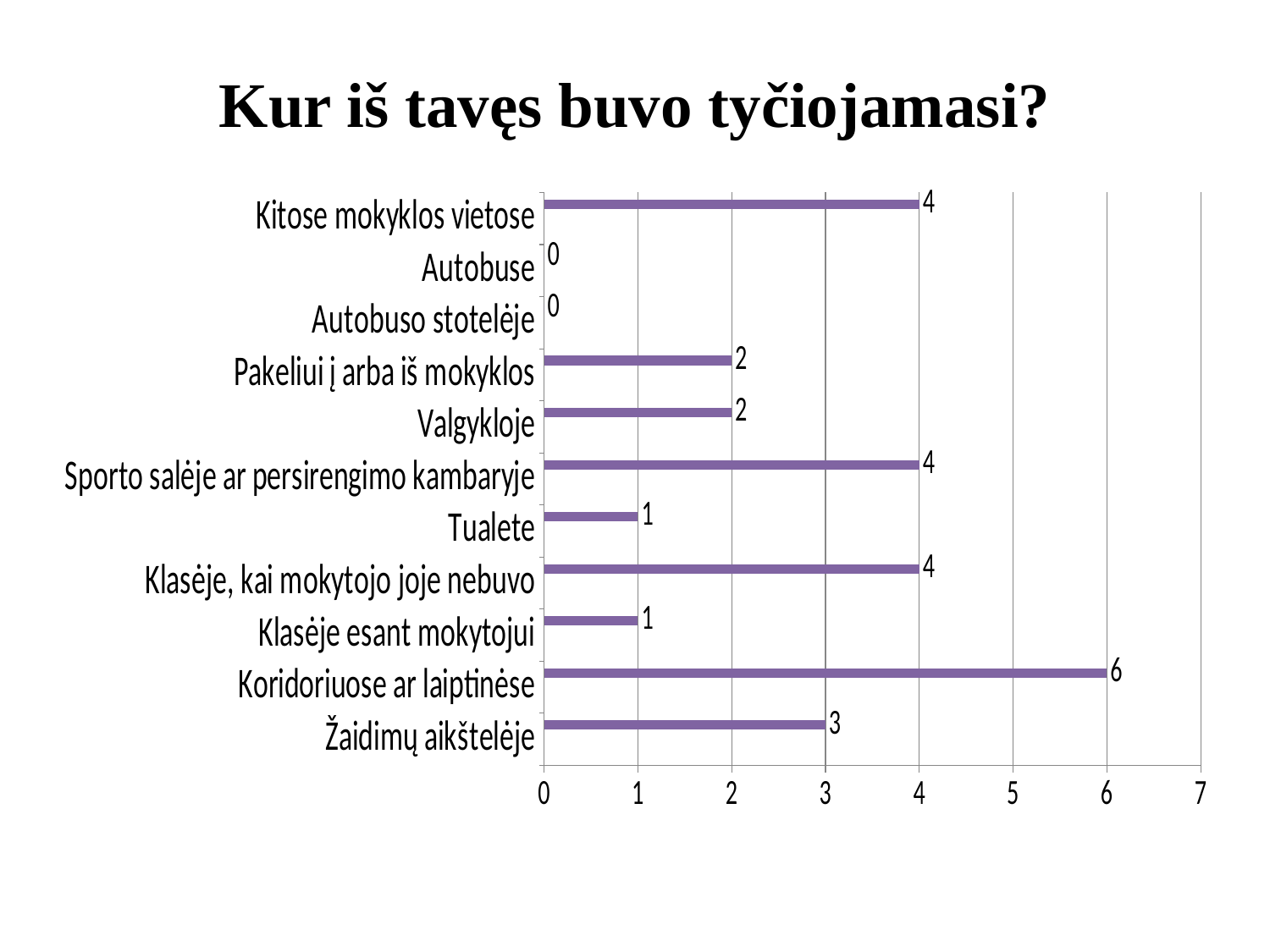
What is the value for Žaidimų aikštelėje? 3 Which category has the highest value? Koridoriuose ar laiptinėse What is the value for Koridoriuose ar laiptinėse? 6 What is the value for Tualete? 1 How many categories are shown on the chart? 11 What is the difference between the values for Koridoriuose ar laiptinėse and Žaidimų aikštelėje? 3 What is the value for Klasėje, kai mokytojo joje nebuvo? 4 How many categories have a value of 0? 2 What kind of chart is shown on the slide? bar chart Which is larger, the value for Kitose mokyklos vietose or the value for Pakeliui į arba iš mokyklos? Kitose mokyklos vietose What is the value for Valgykloje? 2 What is the title of the chart? Kur iš tavęs buvo tyčiojamasi?